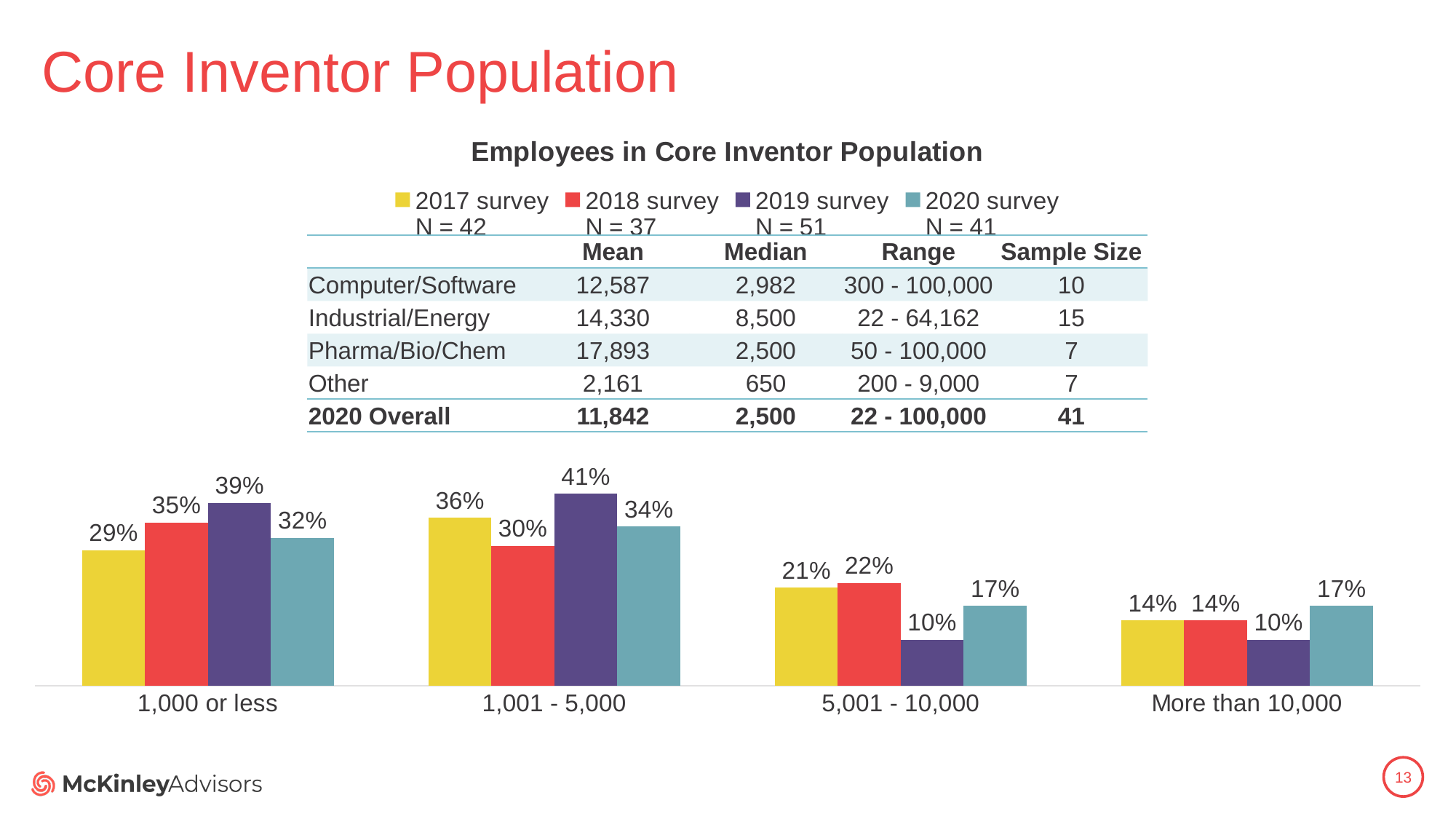
What is the value for the 2020 survey in the '1,000 or less' category? 32% What is the value for the 2019 survey in the '1,001 - 5,000' category? 41% What is the value for the 2017 survey in the '5,001 - 10,000' category? 21% What is the difference between the 2019 survey and 2018 survey values in the '1,000 or less' category? 4% Which category has the lowest value for the 2017 survey? More than 10,000 Which category has the highest value for the 2019 survey? 1,001 - 5,000 Do the 2018 survey values rise or fall from '1,000 or less' to 'More than 10,000'? Fall What kind of chart is shown on the slide? Bar chart Which is larger in the '5,001 - 10,000' category: the 2018 survey value or the 2020 survey value? 2018 survey How many categories are shown on the x axis of the chart? 4 What is the title of the chart? Employees in Core Inventor Population How many series does the chart legend list? 4